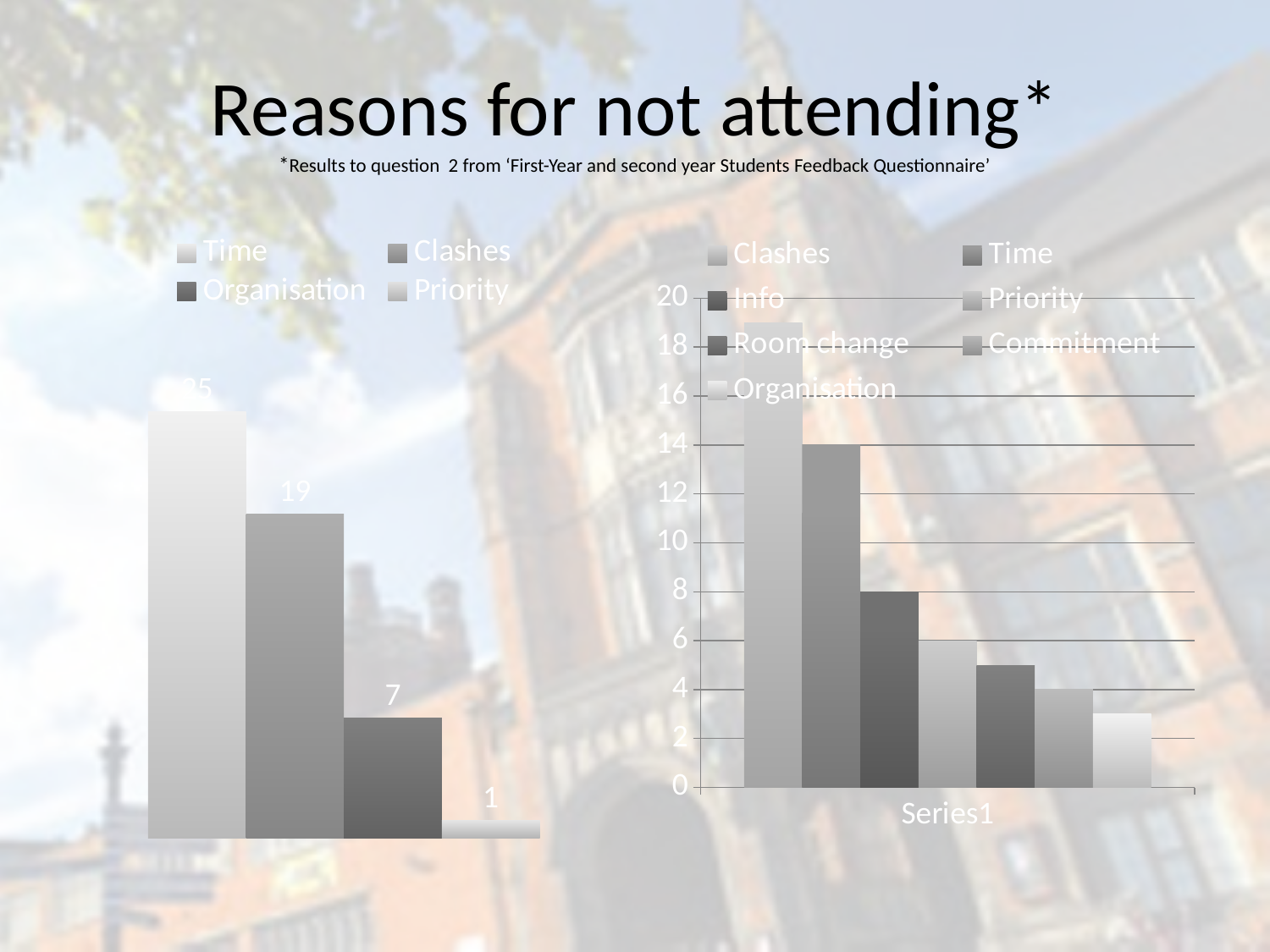
On the right chart, which is larger, the value for Time or the value for Info? Time On the left chart, which category has the lowest value? Priority On the right chart, is the value for Organisation greater or less than 4? less On the left chart, what is the value for Clashes? 19 On the left chart, what is the value for Organisation? 7 On the right chart, is the value for Clashes greater or less than 18? greater On the left chart, what is the value for Time? 25 On the left chart, what is the difference between the values for Time and Clashes? 6 On the right chart, how many entries does the legend list? 7 On the right chart, which category has the highest value? Clashes On the left chart, how many categories does the legend list? 4 What kind of chart is the right chart? Bar chart